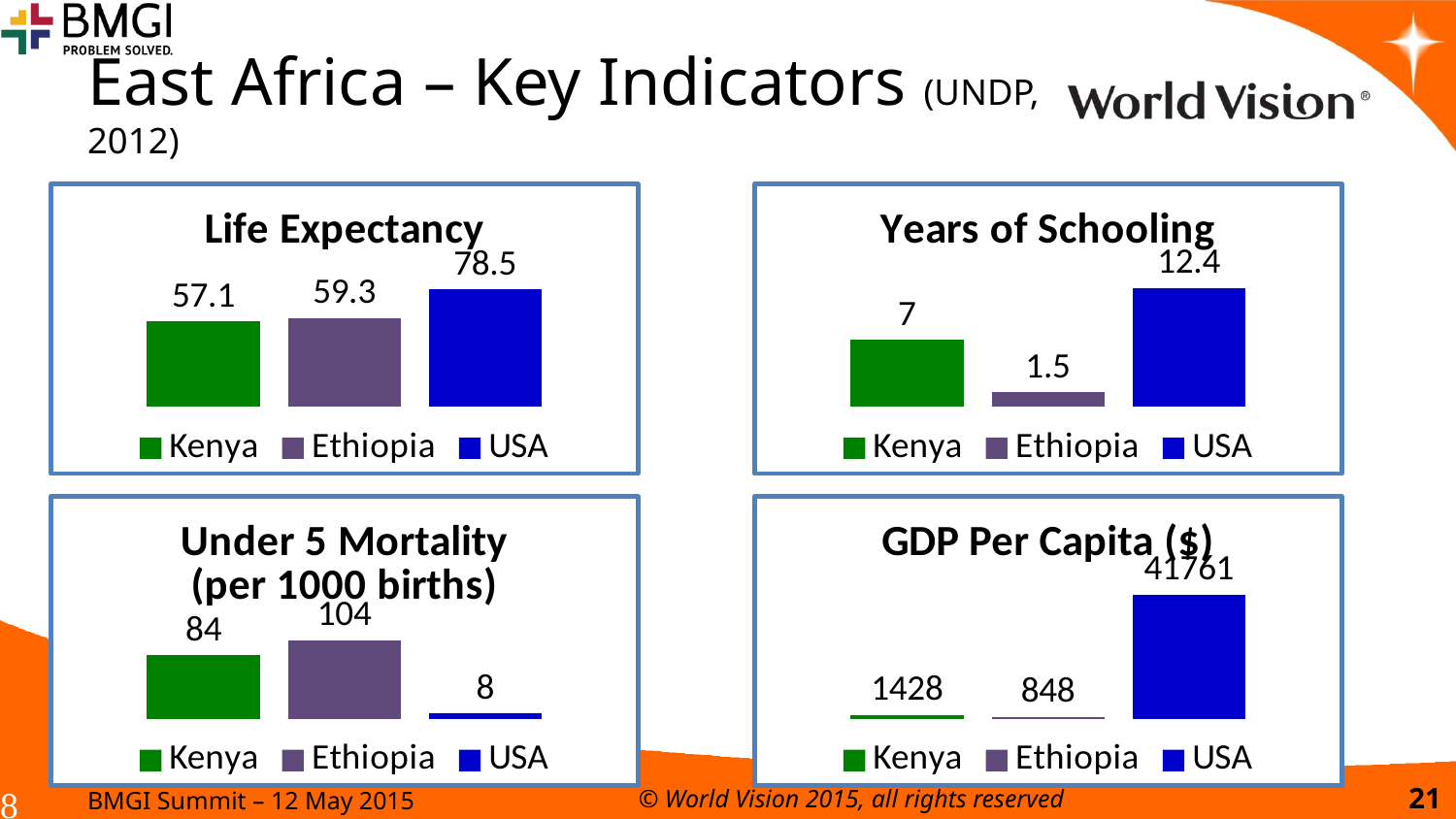
In the Under 5 Mortality (per 1000 births) chart, which country has the highest value? Ethiopia In the Life Expectancy chart, which country has the highest value? USA How many series does the legend of the Life Expectancy chart list? 3 In the GDP Per Capita ($) chart, is the value for Kenya or Ethiopia larger? Kenya In the Under 5 Mortality (per 1000 births) chart, what is the difference between Ethiopia and Kenya? 20 What type of chart is the Years of Schooling chart? Bar chart In the GDP Per Capita ($) chart, which country has the lowest value? Ethiopia In the Under 5 Mortality (per 1000 births) chart, what is the value for the USA? 8 In the GDP Per Capita ($) chart, what is the value for Ethiopia? 848 In the Years of Schooling chart, what is the difference between the USA and Kenya values? 5.4 In the Years of Schooling chart, what is the value for Ethiopia? 1.5 In the Life Expectancy chart, what is the value for Kenya? 57.1